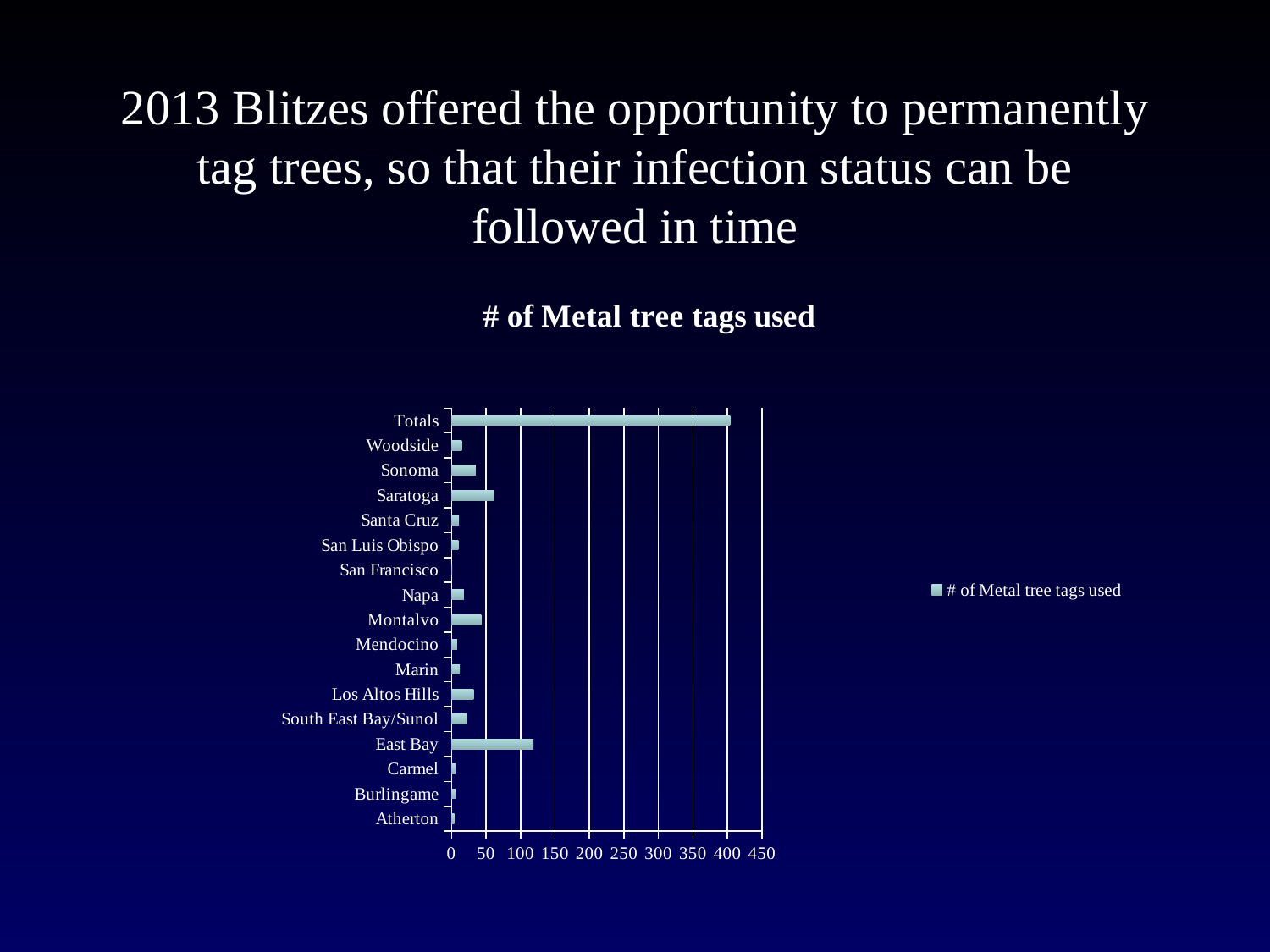
Excluding Totals, which location has the highest number of metal tree tags used? East Bay What is the title of the chart? # of Metal tree tags used How many series does the legend list? 1 Is the value for East Bay greater or less than 100? greater Which category has the longest bar? Totals Which has a larger value, Saratoga or Sonoma? Saratoga Is the value for Saratoga greater or less than 100? less How many categories are plotted on the y axis of the chart? 17 What is the legend entry shown on the chart? # of Metal tree tags used What kind of chart is shown on the slide? bar chart Which has a larger value, Montalvo or Napa? Montalvo